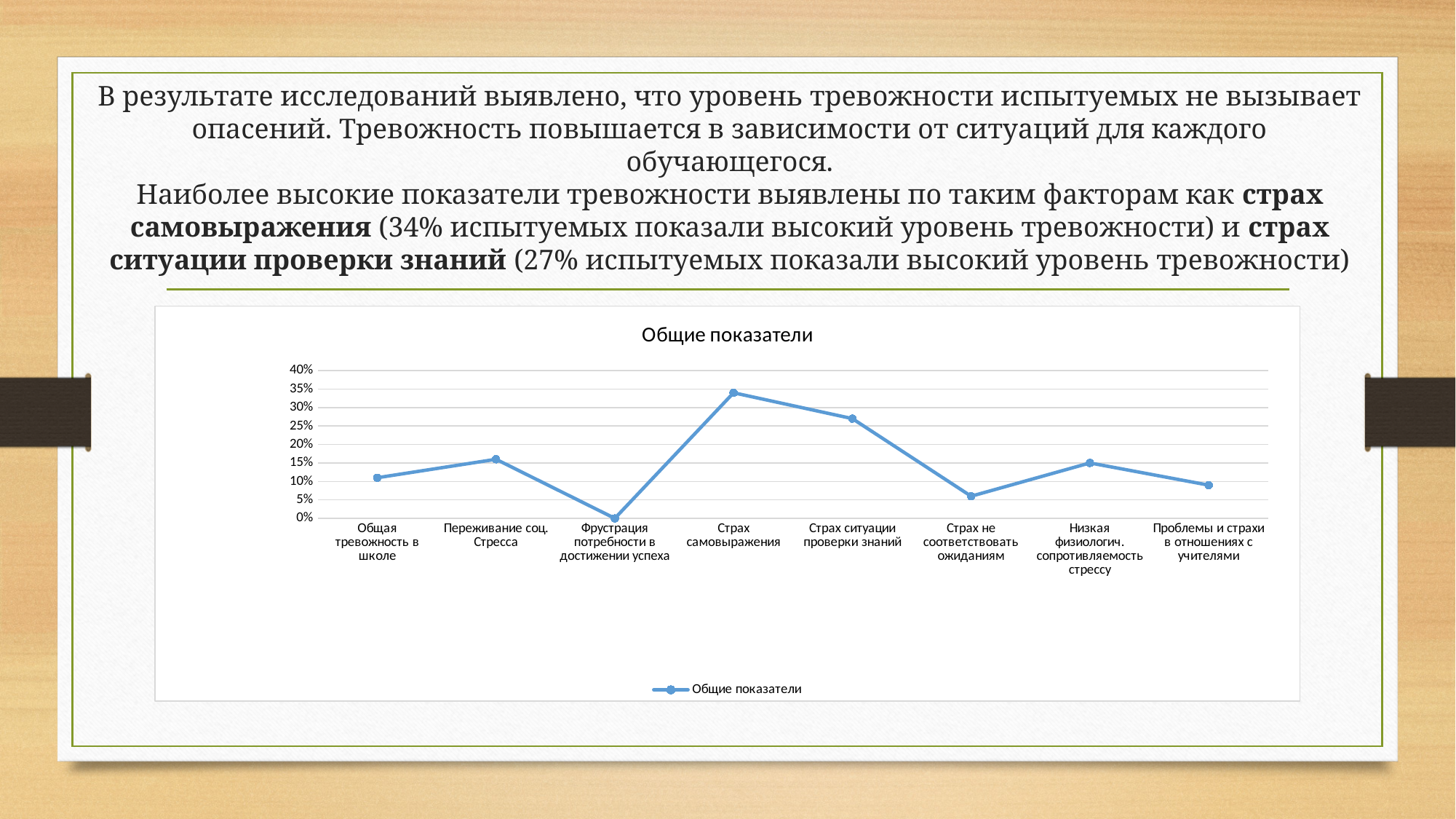
How many categories are plotted along the x axis of the chart? 8 Which category has the highest value in the chart? Страх самовыражения Is the value for Страх самовыражения greater or less than 30%? greater How many series does the chart legend list? 1 Do the values rise or fall from Страх самовыражения to Страх не соответствовать ожиданиям? fall Which is larger: the value for Переживание соц. Стресса or the value for Общая тревожность в школе? Переживание соц. Стресса Is the value for Страх не соответствовать ожиданиям greater or less than 10%? less Is the value for Страх ситуации проверки знаний greater or less than 25%? greater What kind of chart is shown on the slide? Line chart What is the value for Фрустрация потребности в достижении успеха? 0% Which category has the lowest value in the chart? Фрустрация потребности в достижении успеха What is the title of the chart? Общие показатели